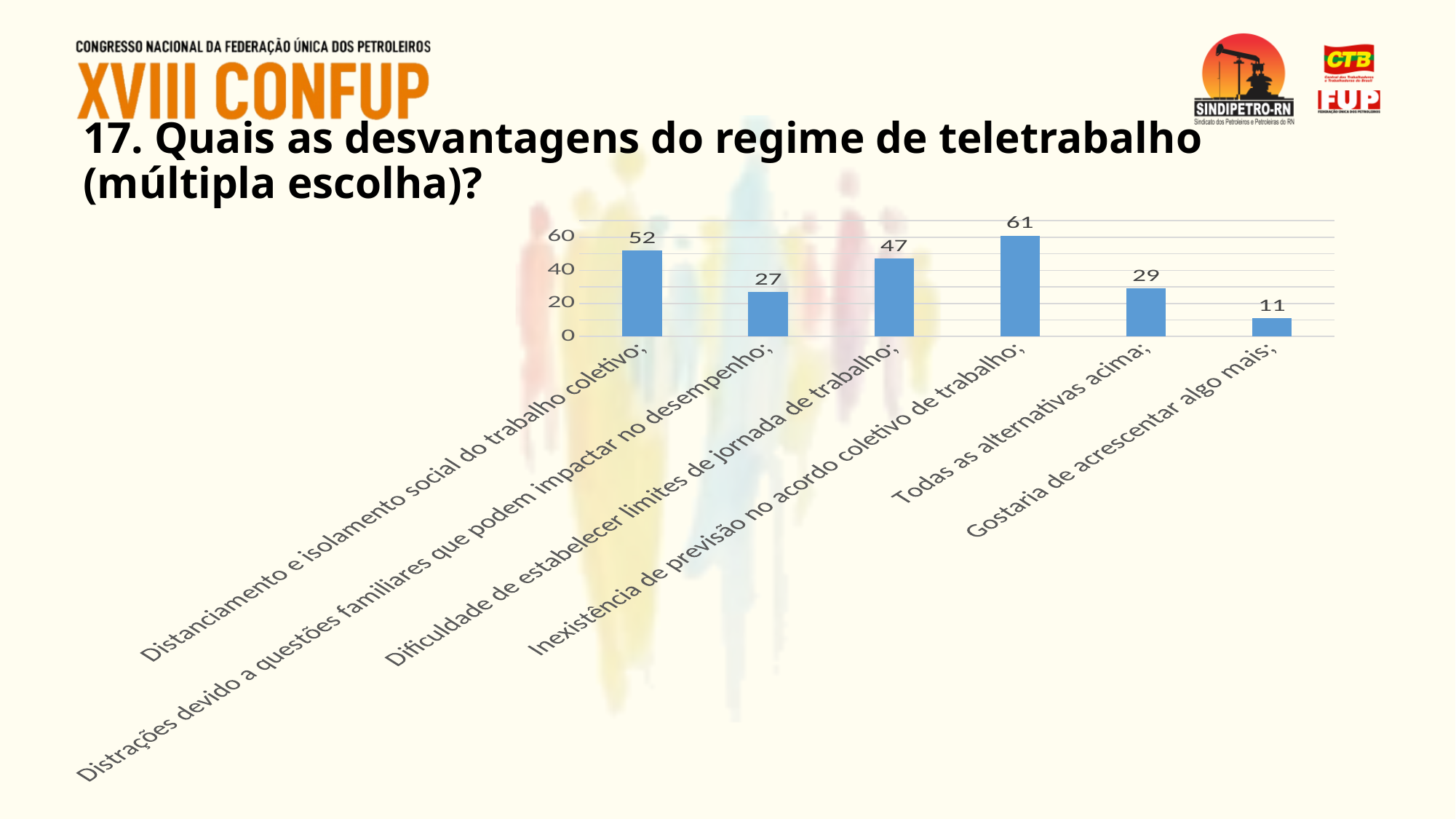
What is the value for "Dificuldade de estabelecer limites de jornada de trabalho"? 47 What kind of chart is shown on the slide? bar chart How many categories are shown in the chart? 6 Which category has the highest value? Inexistência de previsão no acordo coletivo de trabalho Which category has the lowest value? Gostaria de acrescentar algo mais Is the value for "Todas as alternativas acima" greater or less than 40? less What is the title of the slide above the chart? 17. Quais as desvantagens do regime de teletrabalho (múltipla escolha)? What is the value for "Distanciamento e isolamento social do trabalho coletivo"? 52 What is the difference between the values for "Inexistência de previsão no acordo coletivo de trabalho" and "Todas as alternativas acima"? 32 Which is larger: the value for "Distanciamento e isolamento social do trabalho coletivo" or for "Dificuldade de estabelecer limites de jornada de trabalho"? Distanciamento e isolamento social do trabalho coletivo What is the value for "Gostaria de acrescentar algo mais"? 11 What is the value for "Distrações devido a questões familiares que podem impactar no desempenho"? 27